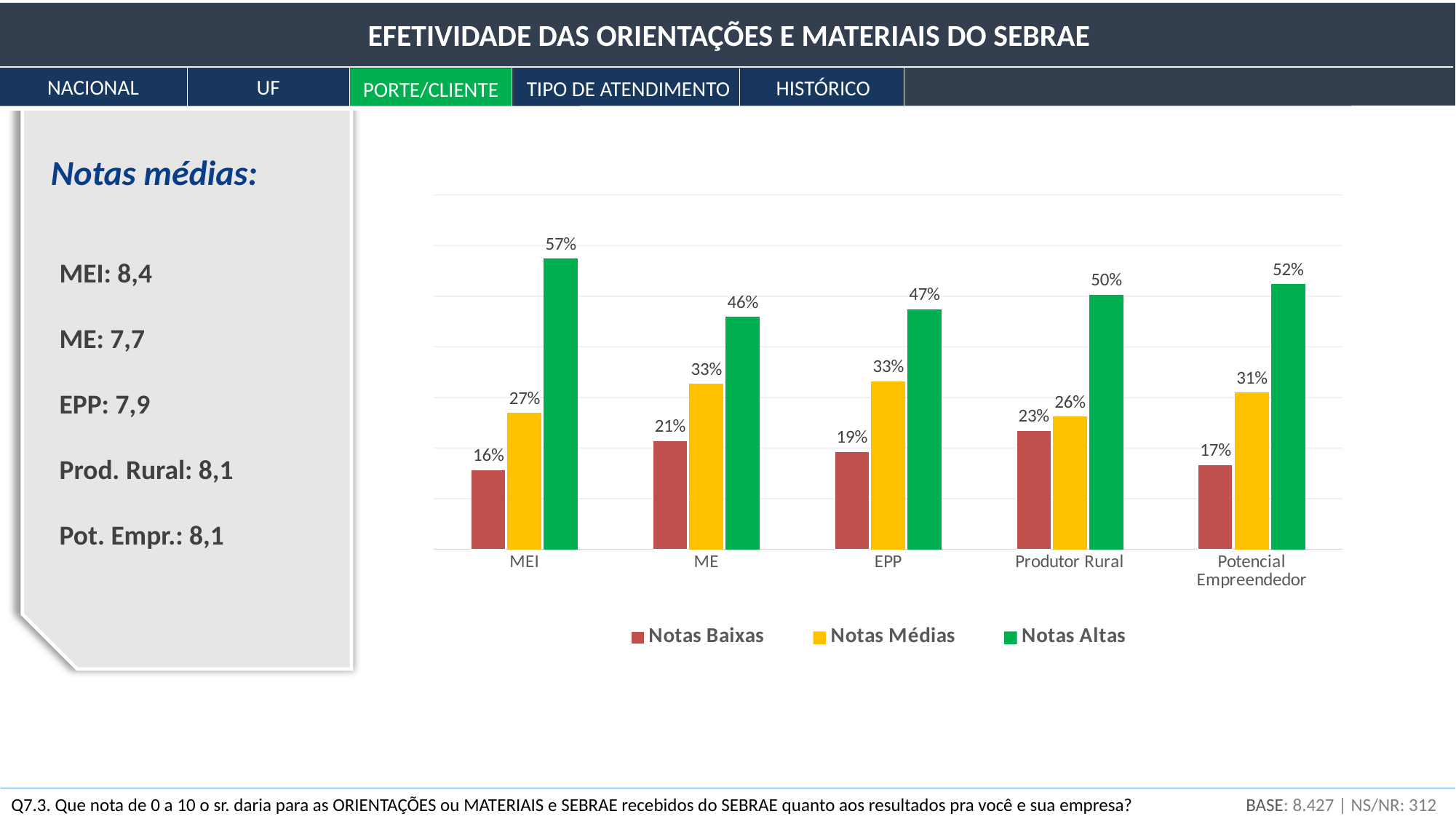
What is the total of the three values for ME? 100% What kind of chart is shown on the slide? Bar chart What is the Notas Baixas value for Produtor Rural? 23% What is the difference between the Notas Altas values for MEI and ME? 11% Which category has the highest Notas Altas value? MEI How many categories are shown on the x axis? 5 Which category has the lowest Notas Baixas value? MEI What is the Notas Médias value for Potencial Empreendedor? 31% Which colour represents Notas Altas in the legend? Green How many series does the legend list? 3 Which is larger, the Notas Médias value for EPP or for Produtor Rural? EPP What is the Notas Altas value for MEI? 57%